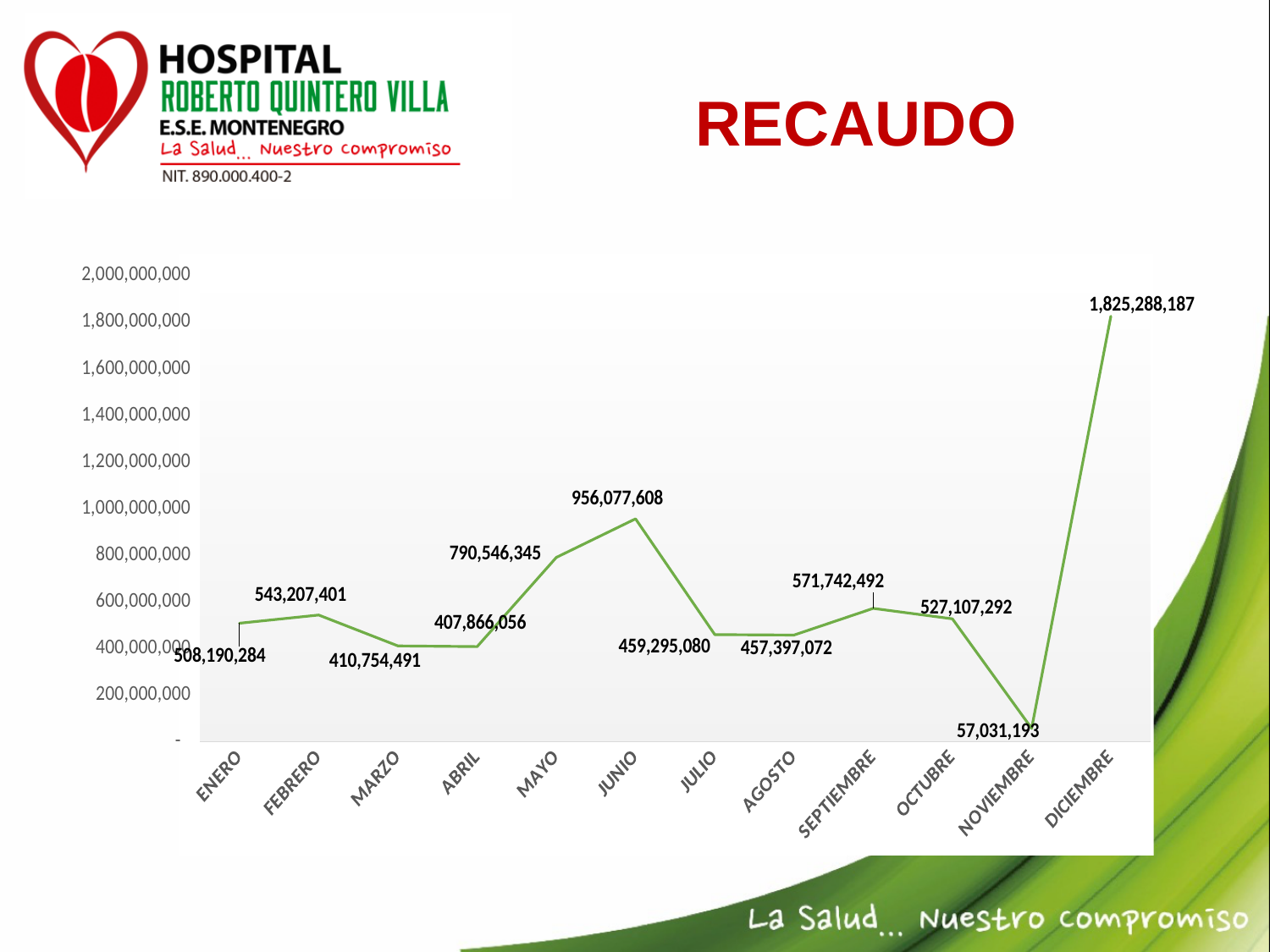
What is the difference between the values for DICIEMBRE and NOVIEMBRE? 1,768,256,994 What is the value for ABRIL? 407,866,056 Which month has the lowest value? NOVIEMBRE What is the difference between the values for JUNIO and MAYO? 165,531,263 What is the title of the chart? RECAUDO What is the value for NOVIEMBRE? 57,031,193 What type of chart is shown on the slide? line chart Which month has the highest value? DICIEMBRE Which is larger, the value for SEPTIEMBRE or the value for OCTUBRE? SEPTIEMBRE How many months are plotted on the x axis? 12 What is the value for JUNIO? 956,077,608 What is the value for MAYO? 790,546,345